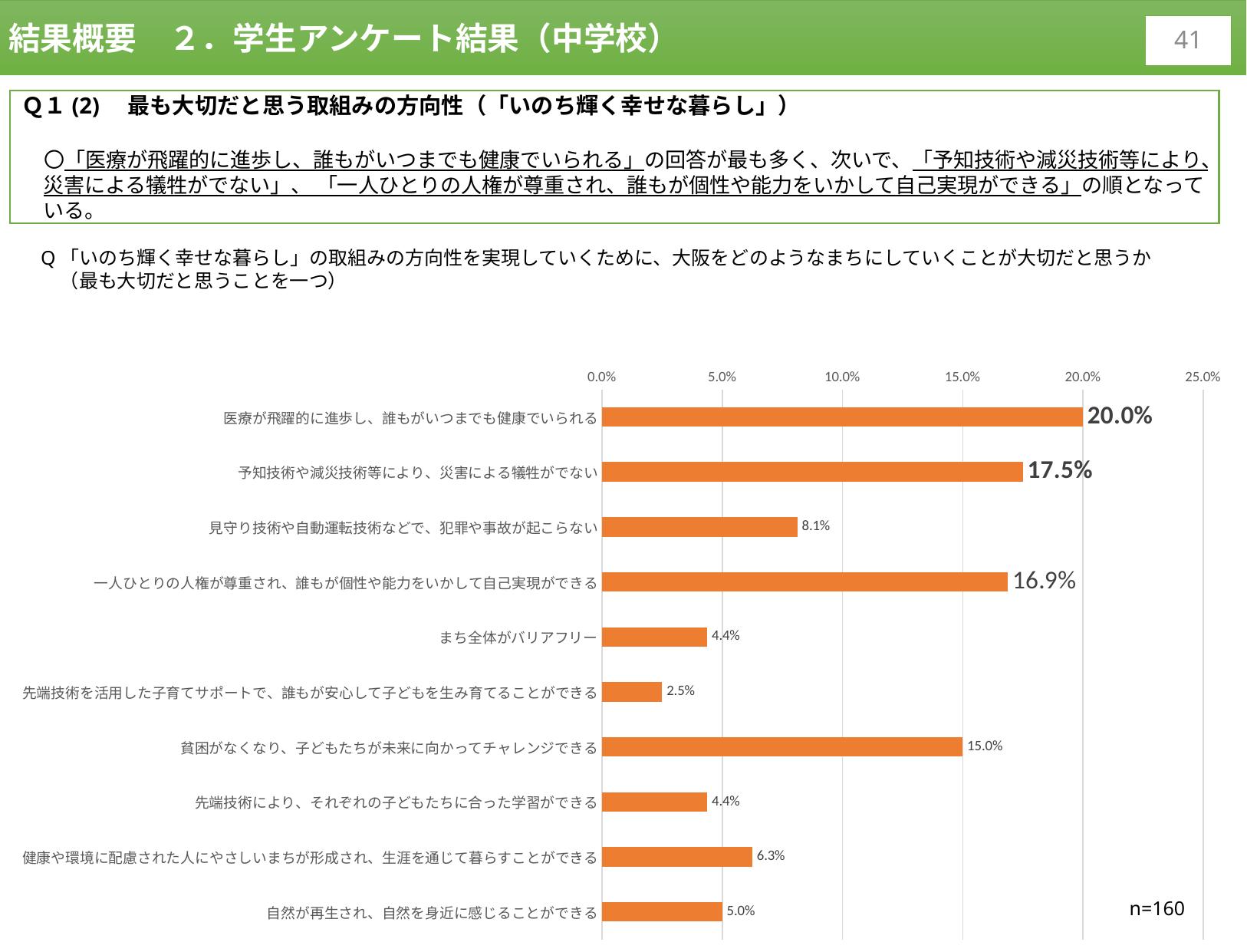
Which is larger: 「見守り技術や自動運転技術などで、犯罪や事故が起こらない」 or 「健康や環境に配慮された人にやさしいまちが形成され、生涯を通じて暮らすことができる」? 見守り技術や自動運転技術などで、犯罪や事故が起こらない What is the maximum value shown on the horizontal axis? 25.0% Which category has the highest value? 医療が飛躍的に進歩し、誰もがいつまでも健康でいられる What is the value for 「先端技術を活用した子育てサポートで、誰もが安心して子どもを生み育てることができる」? 2.5% What is the sample size (n) shown on the chart? n=160 Is the value for 「自然が再生され、自然を身近に感じることができる」 greater or less than 10.0%? less What is the difference between 「予知技術や減災技術等により、災害による犠牲がでない」 and 「一人ひとりの人権が尊重され、誰もが個性や能力をいかして自己実現ができる」? 0.6% What kind of chart is shown on the slide? Bar chart What is the value for 「医療が飛躍的に進歩し、誰もがいつまでも健康でいられる」? 20.0% What is the value for 「貧困がなくなり、子どもたちが未来に向かってチャレンジできる」? 15.0% How many categories are shown in the chart? 10 Which category has the lowest value? 先端技術を活用した子育てサポートで、誰もが安心して子どもを生み育てることができる